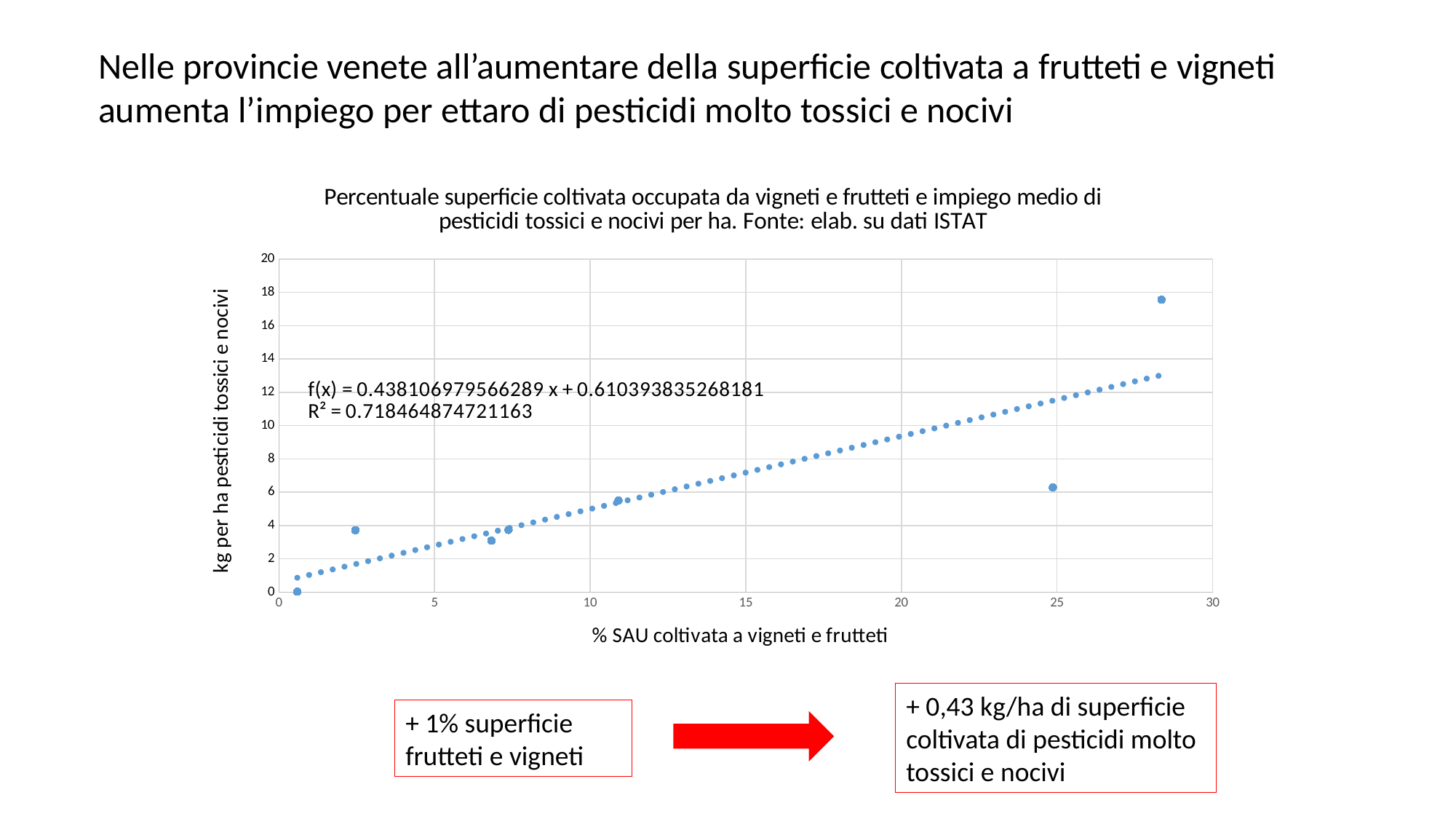
What is the maximum value shown on the y axis? 20 Which point has the highest kg per ha of toxic pesticides: the one at about 28% SAU or the one at about 25% SAU? The one at about 28% SAU Is the value for the point at roughly 25% SAU greater or less than 8 kg per ha? less What kind of chart is shown on the slide? Scatter plot What is the maximum value shown on the x axis? 30 Do the plotted values generally rise or fall as the % SAU coltivata a vigneti e frutteti increases? Rise What is the R² value shown for the trendline? 0.718464874721163 Is the value for the point with the highest % SAU (around 28%) greater or less than 16 kg per ha? greater Is the value for the point at roughly 11% SAU greater or less than 4 kg per ha? greater What is the label of the x axis? % SAU coltivata a vigneti e frutteti